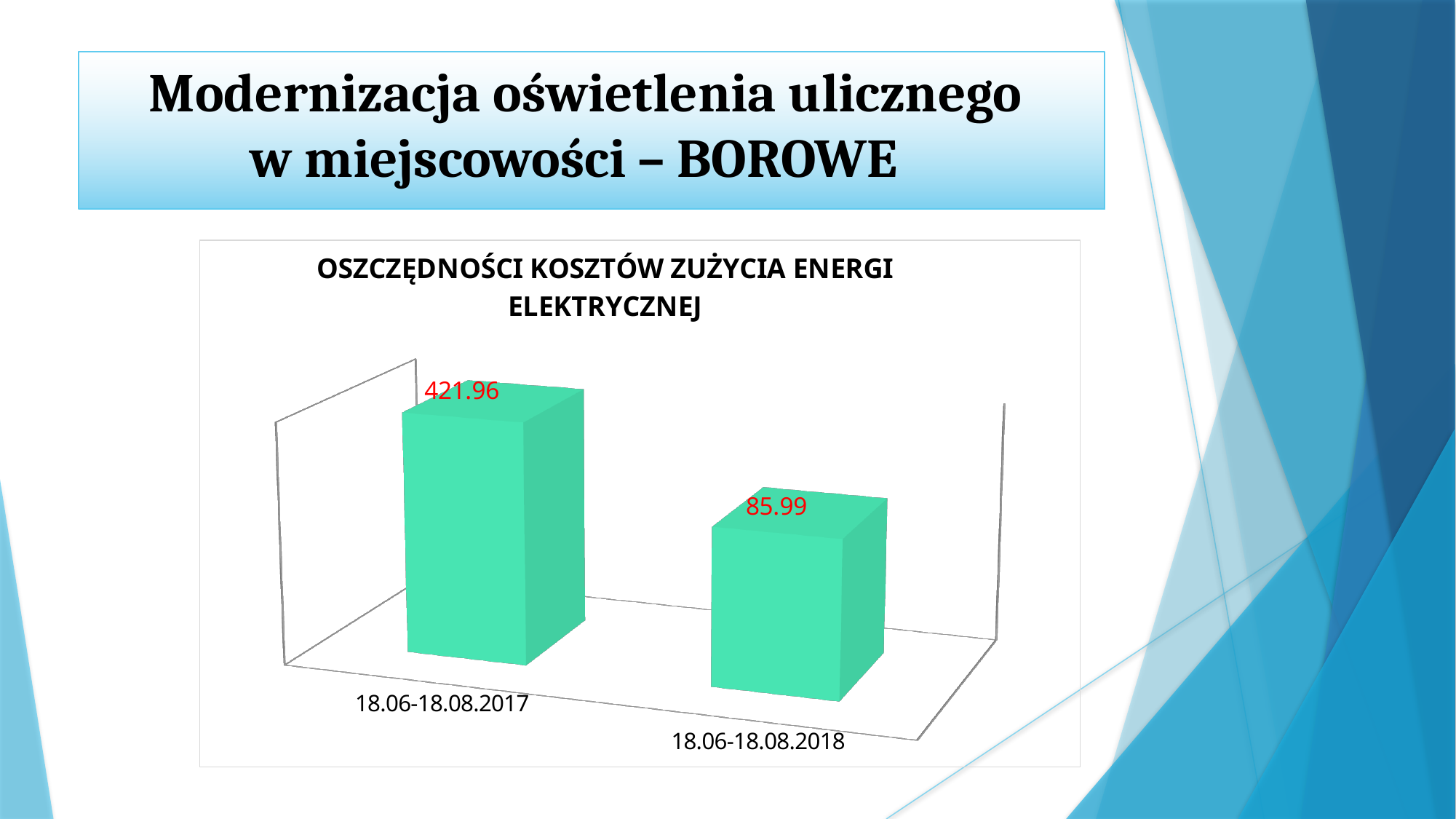
What colour are the bars in the chart? green How many categories are shown in the chart? 2 Which category has the highest value? 18.06-18.08.2017 What is the value for 18.06-18.08.2017? 421.96 Which is larger, the value for 18.06-18.08.2017 or for 18.06-18.08.2018? 18.06-18.08.2017 What is the value for 18.06-18.08.2018? 85.99 What is the title of the chart? OSZCZĘDNOŚCI KOSZTÓW ZUŻYCIA ENERGI ELEKTRYCZNEJ Which category has the lowest value? 18.06-18.08.2018 What kind of chart is shown on the slide? bar chart What is the difference between the values for 18.06-18.08.2017 and 18.06-18.08.2018? 335.97 Do the values rise or fall from 18.06-18.08.2017 to 18.06-18.08.2018? fall